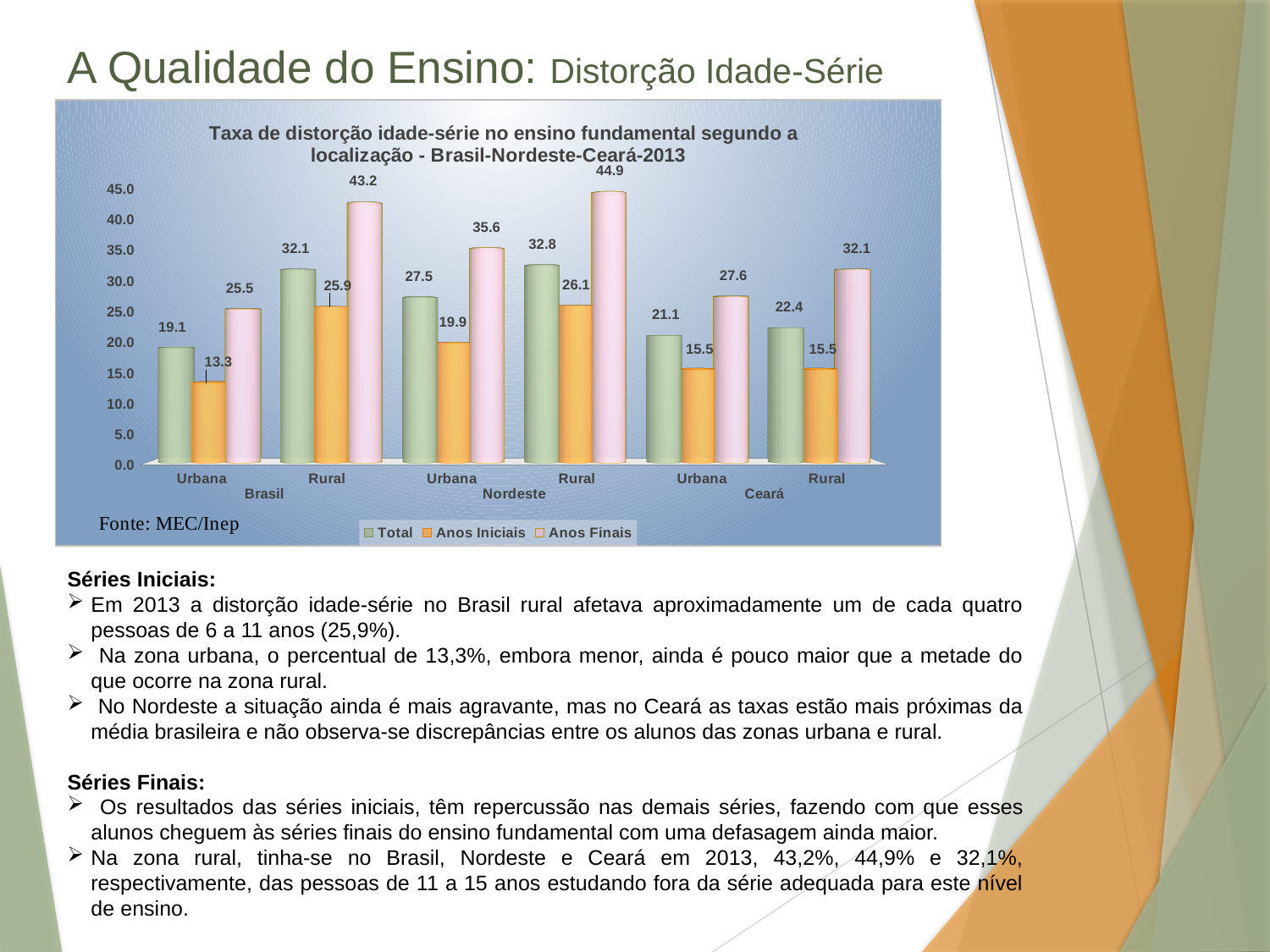
Which category has the highest Anos Finais value? Nordeste Rural What is the difference between the Anos Finais values for Nordeste Rural and Brasil Rural? 1.7 How many categories are shown on the x axis? 6 What is the value of Anos Finais for Brasil Rural? 43.2 Which is larger, the Total value for Ceará Rural or the Total value for Ceará Urbana? Ceará Rural How many series does the legend list? 3 What is the source cited below the chart? MEC/Inep What kind of chart is shown on the slide? Bar chart Which category has the lowest Anos Iniciais value? Brasil Urbana What is the value of Anos Iniciais for Brasil Urbana? 13.3 What is the Total value for Nordeste Urbana? 27.5 What is the value of Anos Finais for Ceará Rural? 32.1